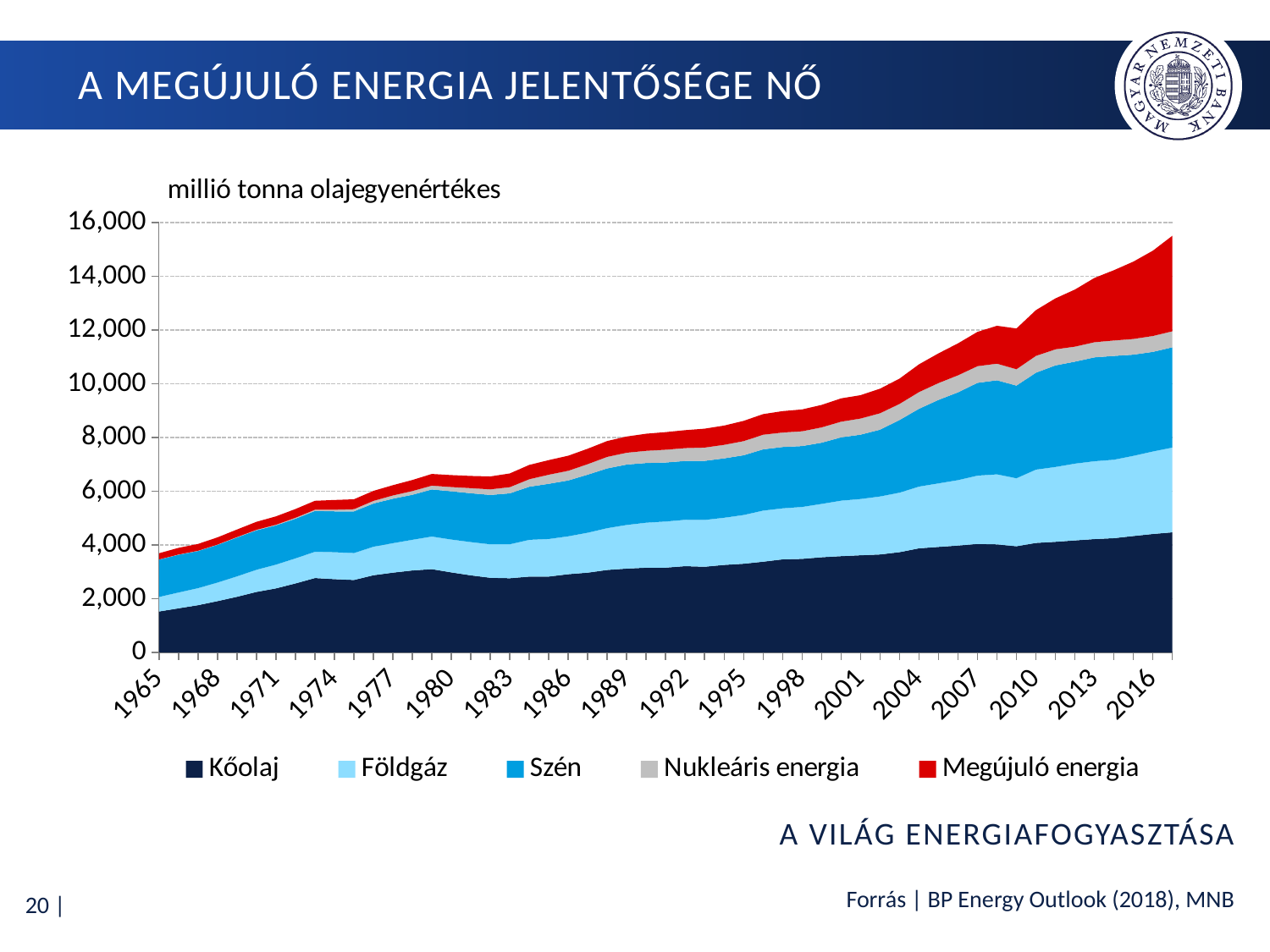
What kind of chart is shown on the slide? stacked area chart Does total world energy consumption rise or fall from 1965 to 2016? rises Is the total energy consumption in 2001 greater or less than 10,000? less How many year labels are shown on the x axis? 18 What unit is given above the chart's y axis? millió tonna olajegyenértékes Which series are listed in the legend? Kőolaj, Földgáz, Szén, Nukleáris energia, Megújuló energia Is the total energy consumption in 1965 greater or less than 4,000? less What is the highest value shown on the y axis? 16,000 Is the total energy consumption in 2016 greater or less than 14,000? greater How many series does the legend list? 5 In 1965, which is larger: Kőolaj or Megújuló energia? Kőolaj